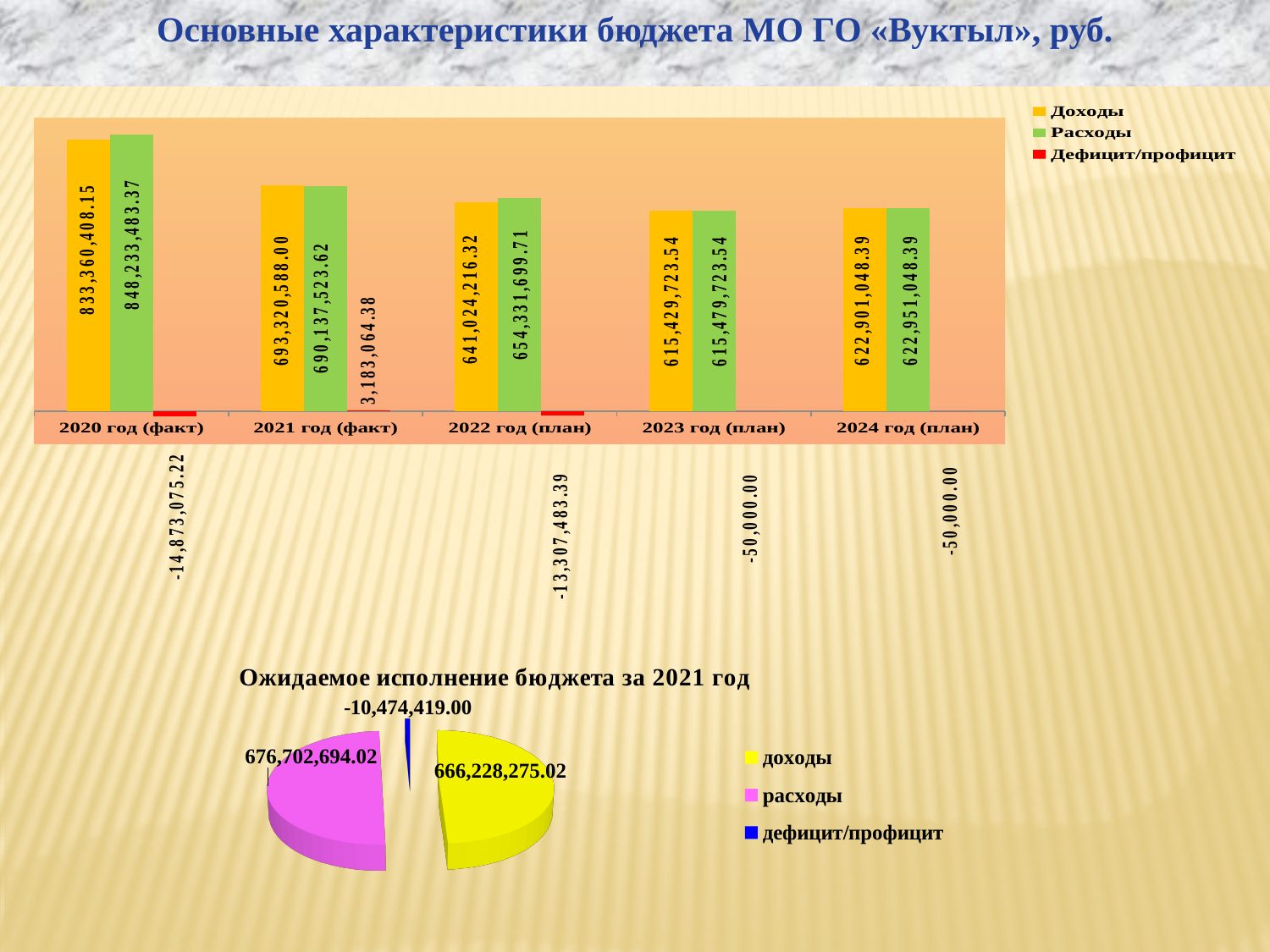
In the bar chart, what is the Дефицит/профицит value for 2024 год (план)? -50,000.00 How many year categories does the bar chart show? 5 What kind of chart is the chart at the bottom of the slide titled 'Ожидаемое исполнение бюджета за 2021 год'? Pie chart In the bar chart, what is the value of Доходы for 2020 год (факт)? 833,360,408.15 In the pie chart 'Ожидаемое исполнение бюджета за 2021 год', what is the value of дефицит/профицит? -10,474,419.00 In the bar chart, which year has the highest Доходы? 2020 год (факт) How many series does the legend of the bar chart list? 3 In the bar chart, what is the Дефицит/профицит value for 2021 год (факт)? 3,183,064.38 In the bar chart, what is the difference between Расходы and Доходы for 2020 год (факт)? 14,873,075.22 In the bar chart, what is the value of Расходы for 2022 год (план)? 654,331,699.71 In the bar chart, which is larger for 2021 год (факт): Доходы or Расходы? Доходы In the pie chart 'Ожидаемое исполнение бюджета за 2021 год', what is the value of расходы? 676,702,694.02